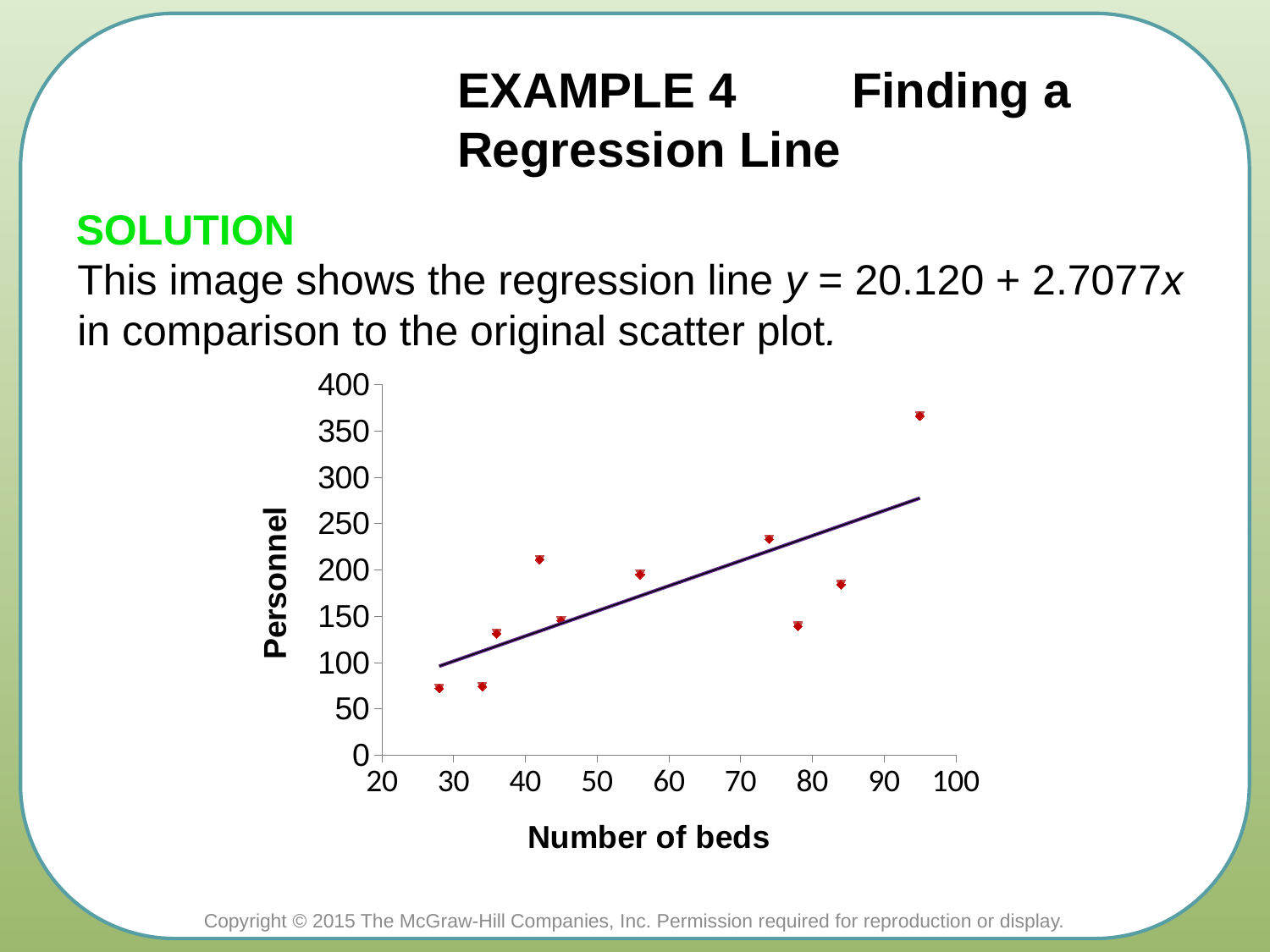
How many plotted points have a Personnel value above 300? 1 How many data points are plotted in the scatter plot? 10 Is the Personnel value for the point nearest 80 beds greater or less than 150? less How many plotted points have a Personnel value below 100? 2 Does the regression line slope upward or downward from left to right? upward What kind of chart is shown on the slide? scatter plot Do the Personnel values generally rise or fall as the Number of beds increases? rise Is the Personnel value of the highest plotted point greater or less than 350? greater What is the label on the vertical axis of the chart? Personnel Is the Personnel value of the lowest plotted point greater or less than 100? less What is the label on the horizontal axis of the chart? Number of beds